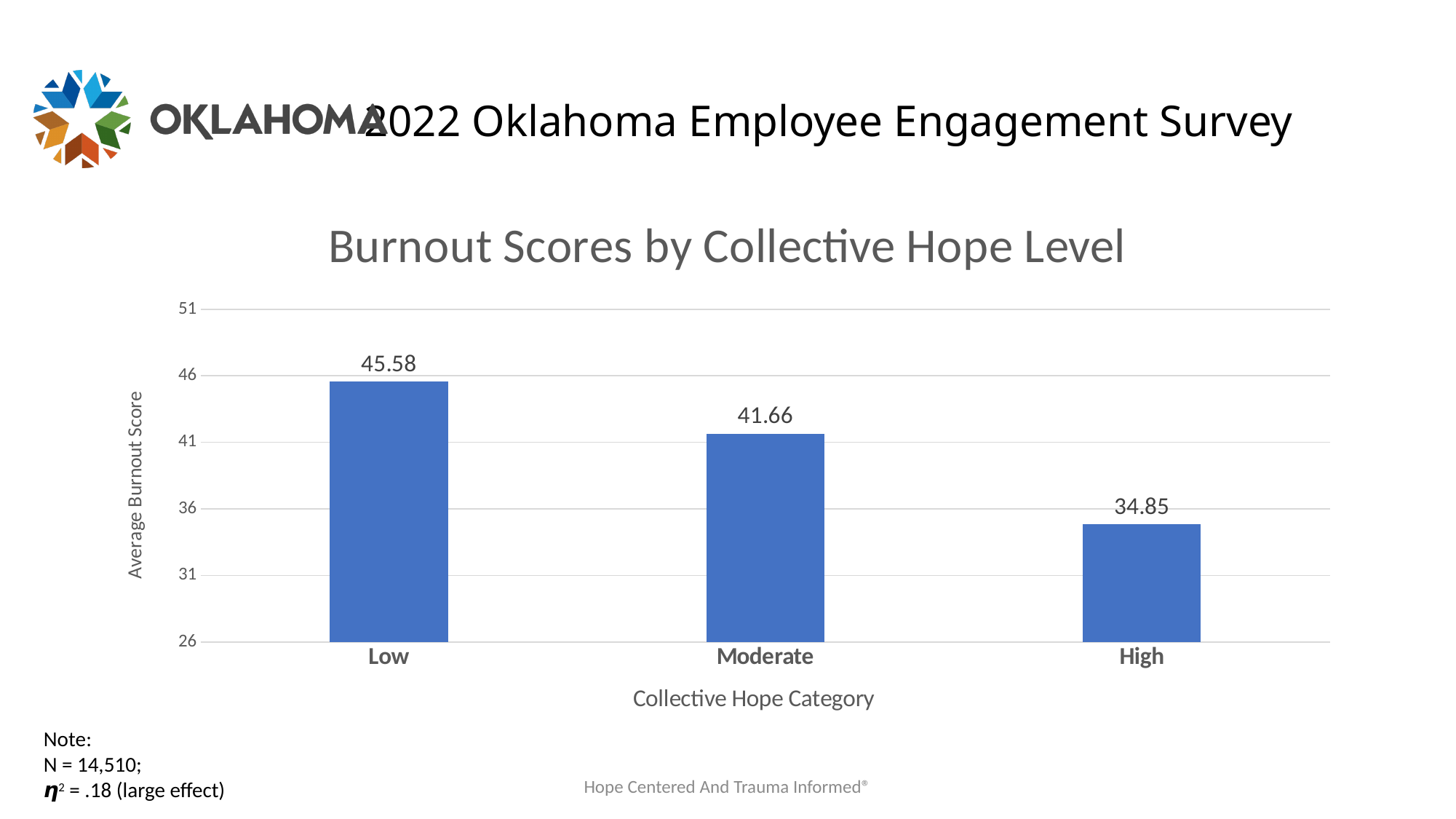
What is the average burnout score for the Low collective hope category? 45.58 What is the difference between the average burnout scores for the Low and High categories? 10.73 What is the average burnout score for the High collective hope category? 34.85 Is the average burnout score for the Moderate category greater or less than 41? greater How many collective hope categories are shown on the chart? 3 What is the difference between the average burnout scores for the Low and Moderate categories? 3.92 Which collective hope category has the lowest average burnout score? High What kind of chart is shown on the slide? Bar chart Do the average burnout scores rise or fall as collective hope goes from Low to High? Fall Which collective hope category has the highest average burnout score? Low Which has a higher average burnout score, Moderate or High? Moderate What is the average burnout score for the Moderate collective hope category? 41.66